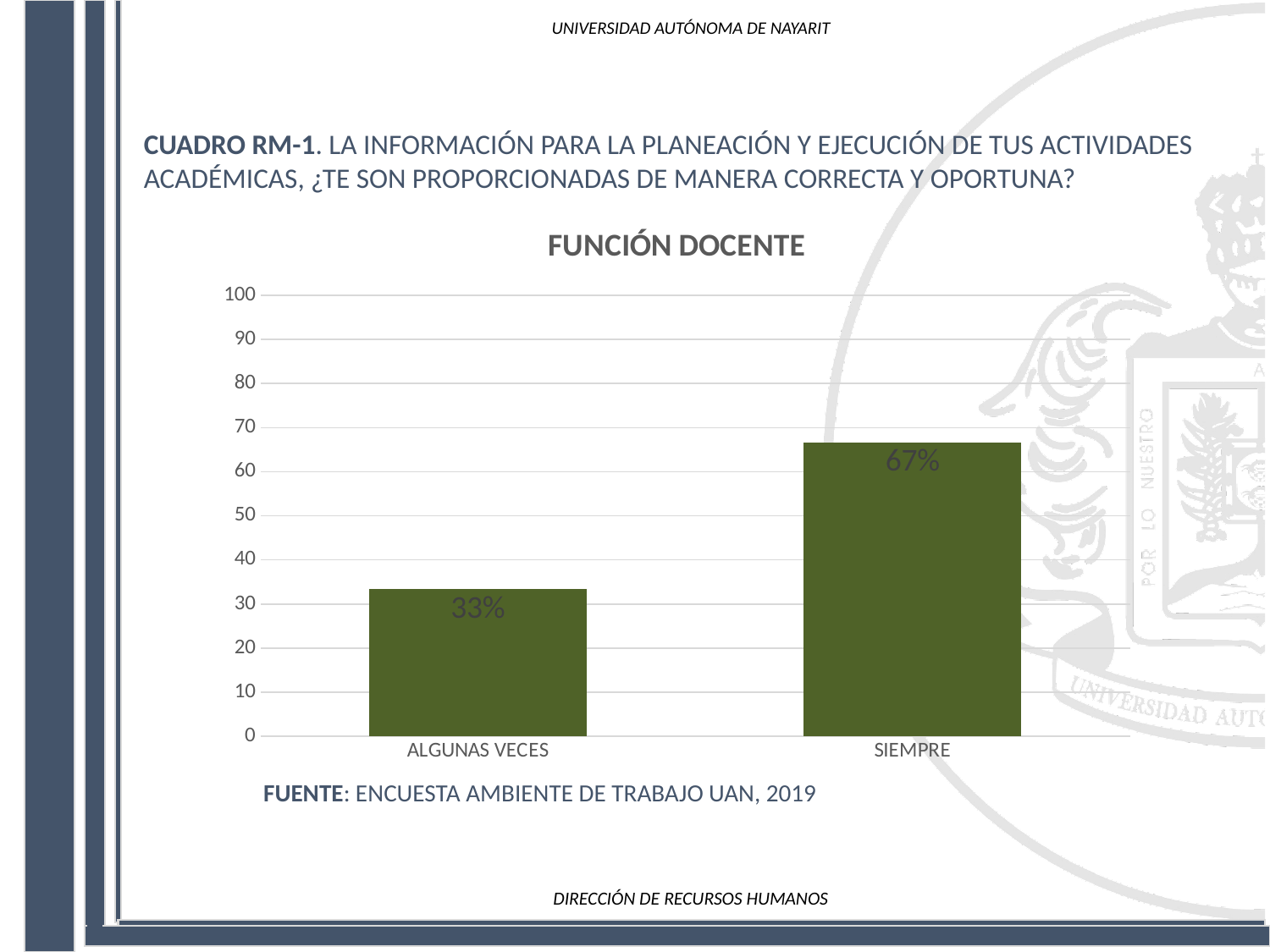
Which category has the lowest value? ALGUNAS VECES Is the value for ALGUNAS VECES greater or less than 40? less Is the value for SIEMPRE greater or less than 50? greater Which is larger, the value for ALGUNAS VECES or the value for SIEMPRE? SIEMPRE What is the value for SIEMPRE? 67% Which category has the highest value? SIEMPRE What is the highest value shown on the vertical axis? 100 What kind of chart is shown on the slide? bar chart What is the value for ALGUNAS VECES? 33% What is the difference between the values for SIEMPRE and ALGUNAS VECES? 34% What is the title of the chart? FUNCIÓN DOCENTE How many categories are shown on the x axis? 2